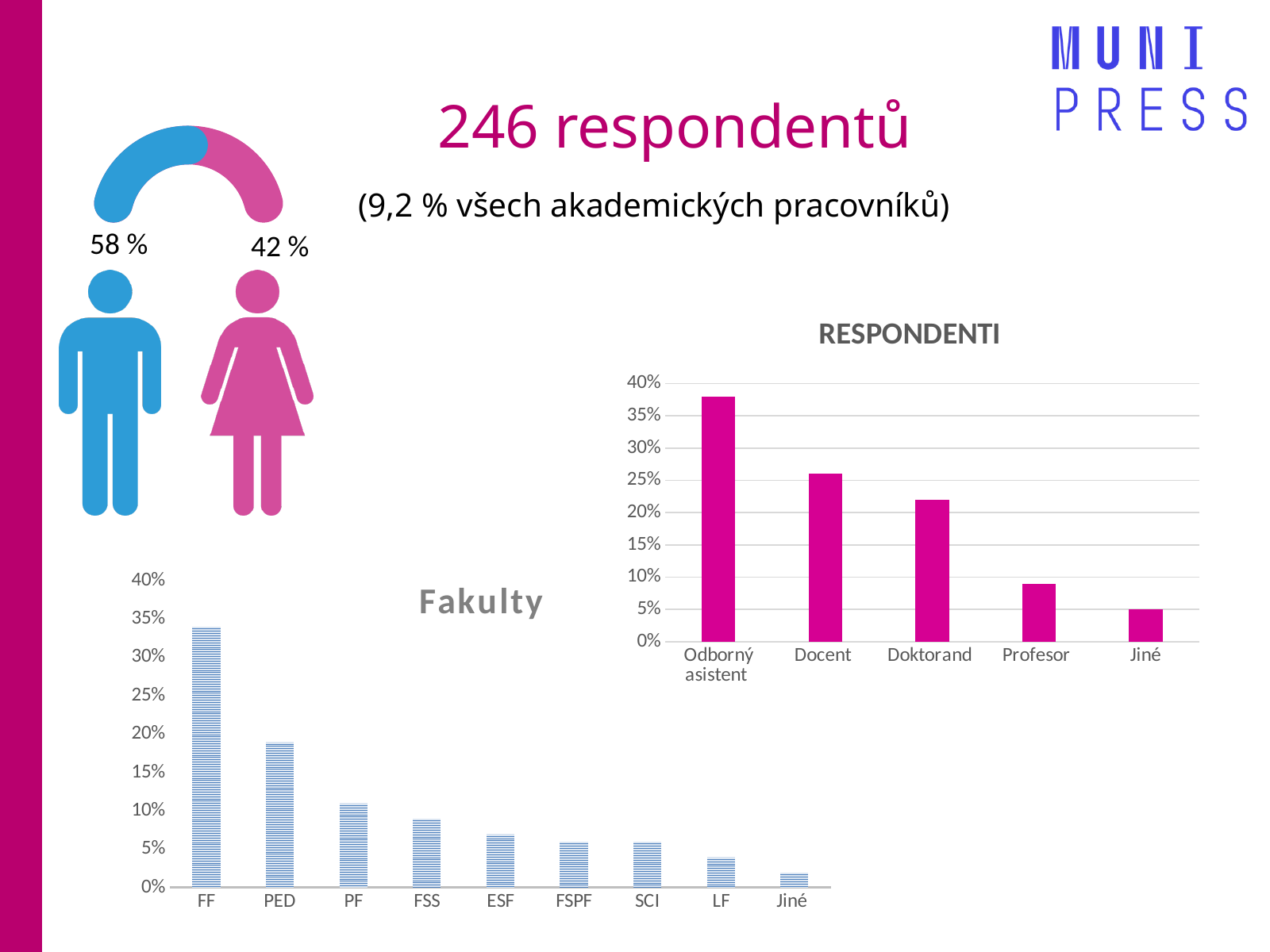
In the Fakulty chart, which faculty has the highest value? FF What kind of chart is the Fakulty chart? bar chart How many categories are shown in the RESPONDENTI chart? 5 In the Fakulty chart, is the value for LF greater or less than 5%? less How many categories are shown in the Fakulty chart? 9 In the RESPONDENTI chart, is the value for Profesor greater or less than 10%? less In the Fakulty chart, is the value for PED greater or less than 15%? greater In the RESPONDENTI chart, which category has the lowest value? Jiné In the RESPONDENTI chart, which is larger, Docent or Doktorand? Docent In the Fakulty chart, which category has the lowest value? Jiné In the RESPONDENTI chart, which category has the highest value? Odborný asistent